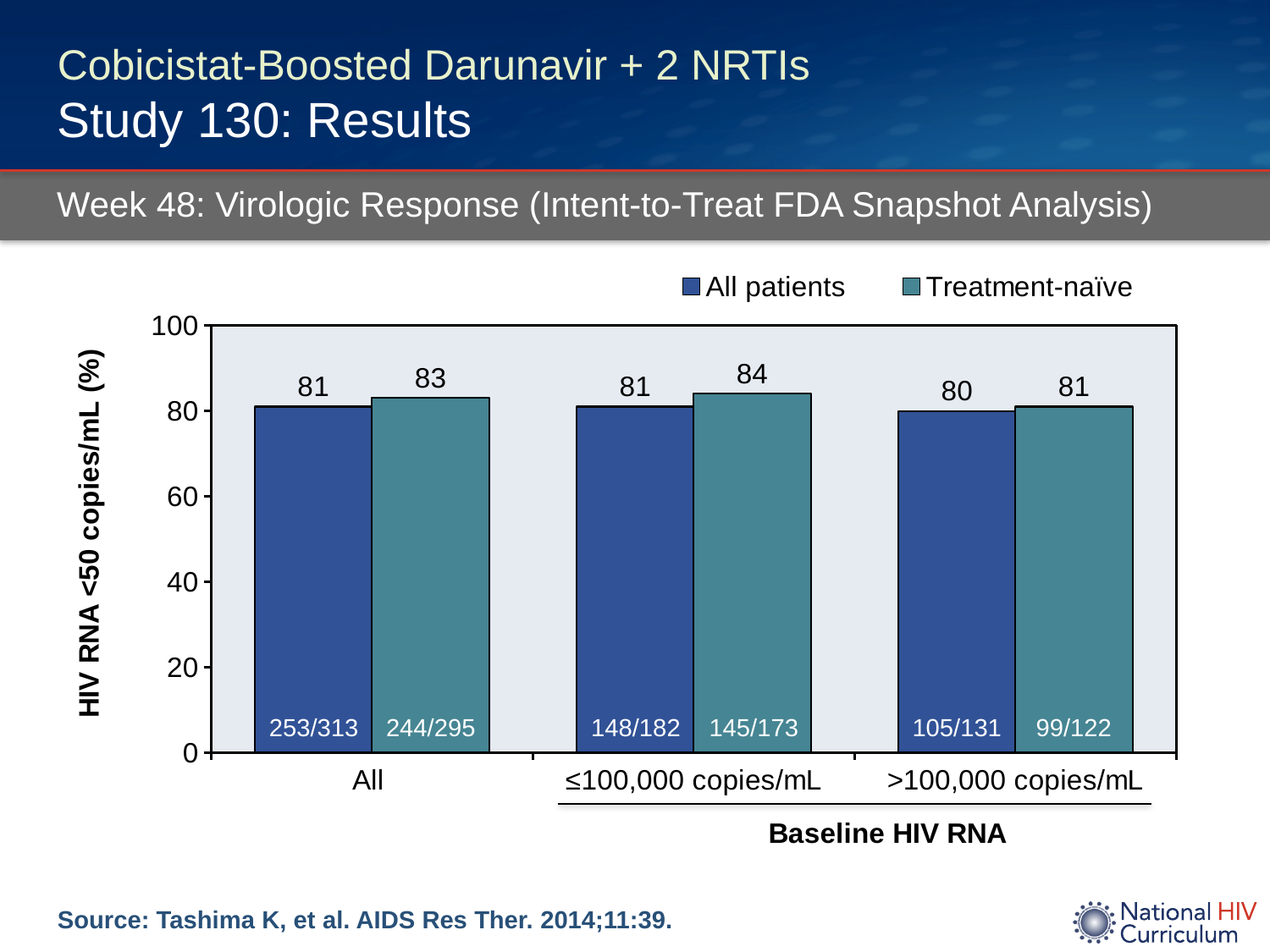
What is the value for All patients in the All category? 81 What fraction is printed inside the Treatment-naïve bar for the >100,000 copies/mL category? 99/122 What is the value for Treatment-naïve in the All category? 83 What is the value for All patients in the >100,000 copies/mL category? 80 What is the value for Treatment-naïve in the ≤100,000 copies/mL category? 84 What kind of chart is shown on the slide? Bar chart Which category has the highest Treatment-naïve value? ≤100,000 copies/mL How many categories are shown on the x axis? 3 In the All category, which series has the larger value, All patients or Treatment-naïve? Treatment-naïve Which category has the lowest All patients value? >100,000 copies/mL What is the difference between the Treatment-naïve and All patients values in the ≤100,000 copies/mL category? 3 How many series does the legend list? 2